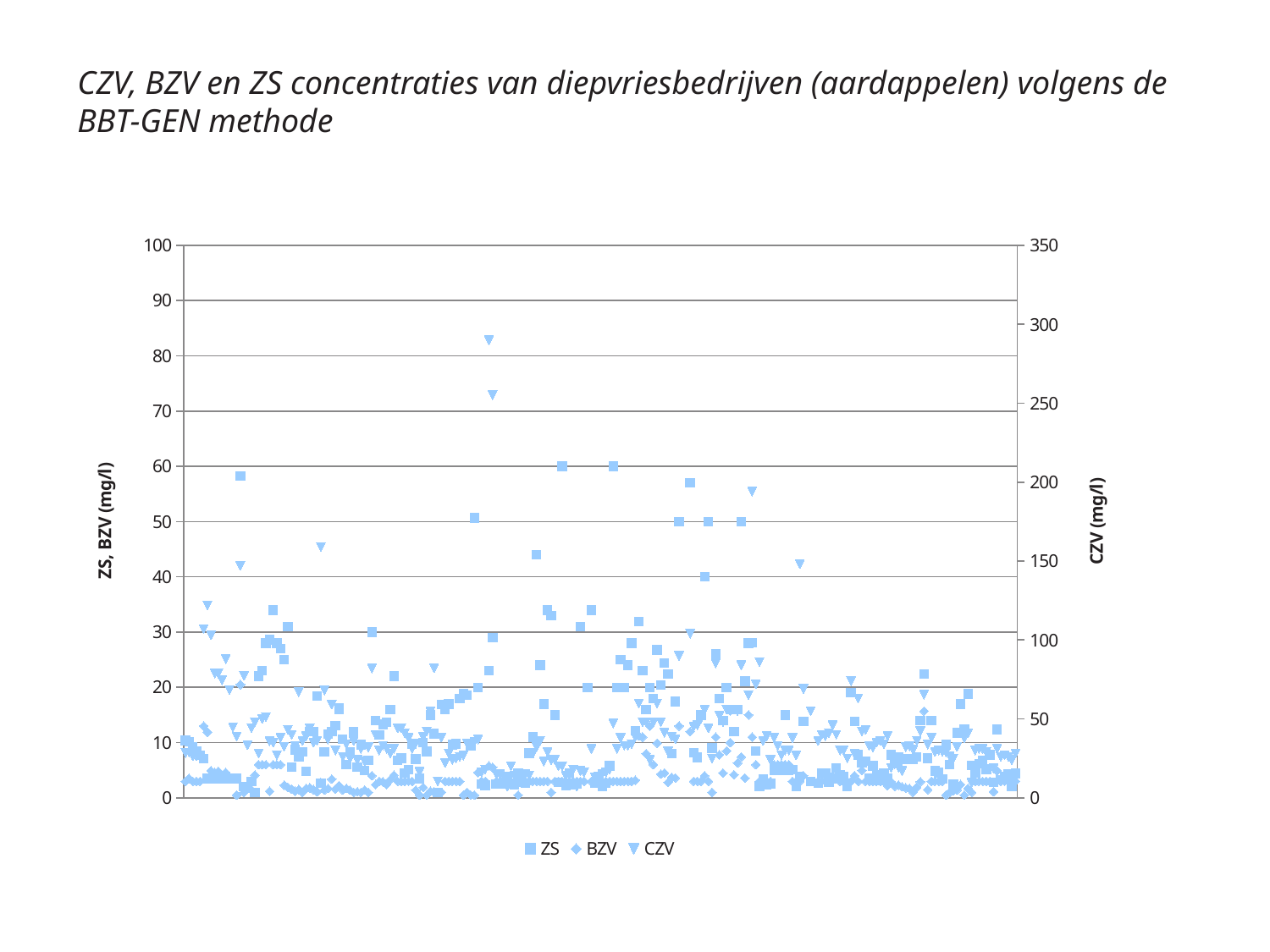
What is the maximum value shown on the left vertical axis? 100 What is the title of the left vertical axis? ZS, BZV (mg/l) Is the highest CZV point greater or less than 250 mg/l on the right axis? greater What kind of chart is shown on the slide? Scatter chart Is the highest BZV point greater or less than 30 mg/l on the left axis? less Is the highest ZS point greater or less than 50 mg/l on the left axis? greater What is the maximum value shown on the right vertical axis (CZV)? 350 How many series does the legend list? 3 Which series are listed in the legend? ZS, BZV, CZV